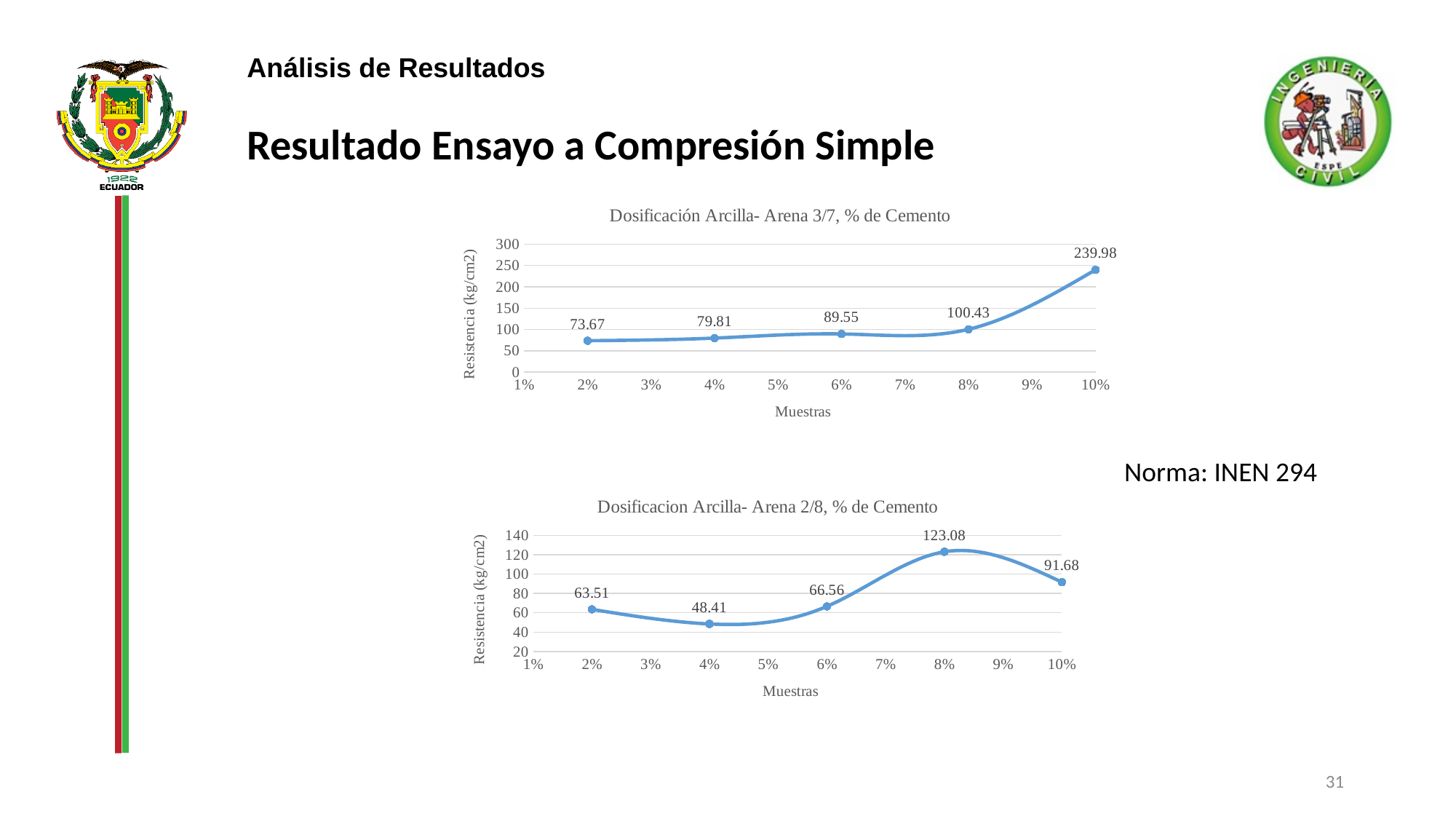
In the chart titled 'Dosificacion Arcilla- Arena 2/8, % de Cemento', which sample percentage has the lowest resistance? 4% In the chart titled 'Dosificacion Arcilla- Arena 2/8, % de Cemento', which sample percentage has the highest resistance? 8% What type of chart is the bottom chart on the slide? line chart In the chart titled 'Dosificacion Arcilla- Arena 2/8, % de Cemento', which is larger, the value at 2% or the value at 6%? 6% In the chart titled 'Dosificación Arcilla- Arena 3/7, % de Cemento', what is the resistance value at 2%? 73.67 In the chart titled 'Dosificacion Arcilla- Arena 2/8, % de Cemento', what is the difference between the values at 8% and 10%? 31.40 In the chart titled 'Dosificación Arcilla- Arena 3/7, % de Cemento', how many data points are plotted? 5 In the chart titled 'Dosificación Arcilla- Arena 3/7, % de Cemento', which sample percentage has the lowest resistance? 2% In the chart titled 'Dosificacion Arcilla- Arena 2/8, % de Cemento', what is the resistance value at 8%? 123.08 In the chart titled 'Dosificación Arcilla- Arena 3/7, % de Cemento', do the values rise or fall as the sample percentage increases? rise In the chart titled 'Dosificación Arcilla- Arena 3/7, % de Cemento', what is the difference between the values at 10% and 8%? 139.55 In the chart titled 'Dosificación Arcilla- Arena 3/7, % de Cemento', what is the resistance value at 10%? 239.98